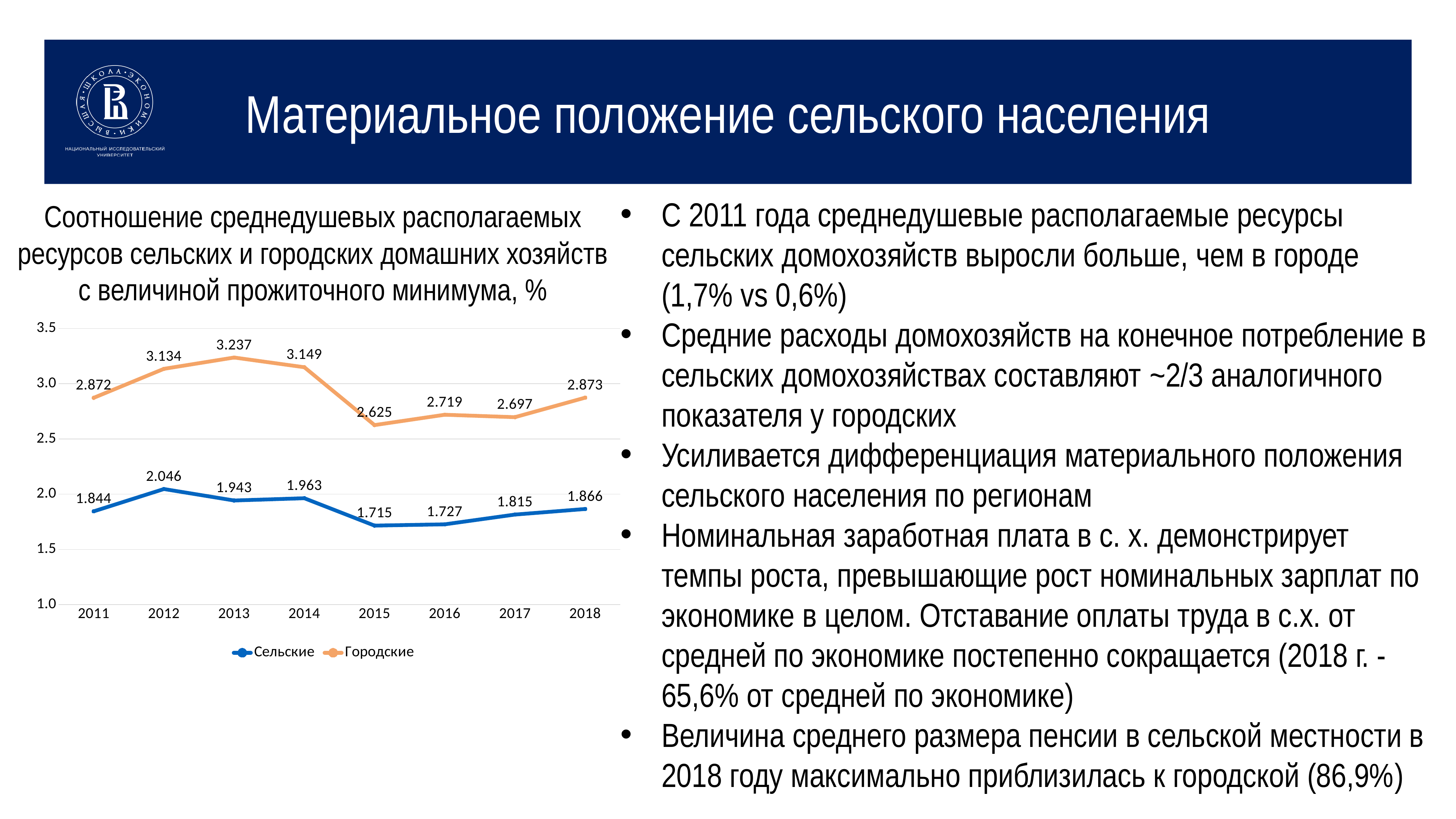
How many years are shown on the x axis? 8 By how much did the Сельские value change from 2011 to 2012? 0.202 How many series does the legend list? 2 What kind of chart is shown on the slide? Line chart In which year is the Городские series at its highest? 2013 What is the value for Сельские in 2018? 1.866 What is the difference between the Городские and Сельские values in 2013? 1.294 In which year is the Сельские series at its lowest? 2015 What is the value for Городские in 2013? 3.237 What is the value for Сельские in 2015? 1.715 Which is larger, the Сельские value in 2012 or in 2018? 2012 Which colour is used for the Сельские series? Blue